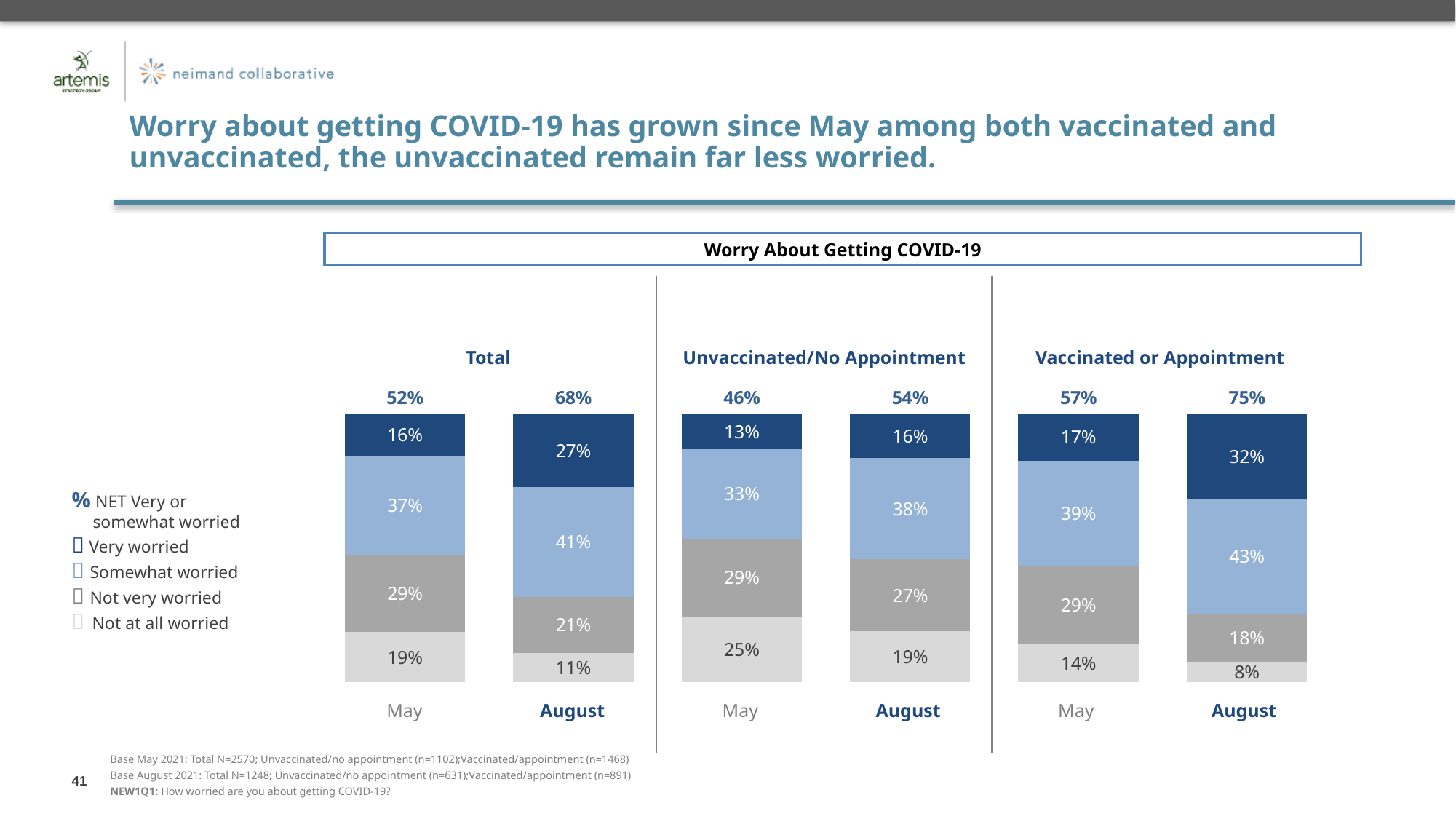
What is the NET Very or somewhat worried percentage for the Vaccinated or Appointment group in August? 75% By how many percentage points did the NET Very or somewhat worried figure for the Total group change from May to August? 16 percentage points In the Unvaccinated/No Appointment group, what percentage were Not at all worried in May? 25% In August, which group has a larger Very worried share: Unvaccinated/No Appointment or Vaccinated or Appointment? Vaccinated or Appointment What is the difference between the Not very worried percentages for the Total group in May and August? 8 percentage points In the Vaccinated or Appointment group, what percentage were Somewhat worried in August? 43% Which group and month has the highest NET Very or somewhat worried percentage? Vaccinated or Appointment, August (75%) How many response categories does the legend list for the stacked bars (excluding the NET line)? 4 What kind of chart is shown under the title "Worry About Getting COVID-19"? Stacked bar chart In the Total group, what percentage were Very worried in August? 27% Which group and month has the lowest NET Very or somewhat worried percentage? Unvaccinated/No Appointment, May (46%) Does the NET Very or somewhat worried percentage rise or fall from May to August in every group? Rise